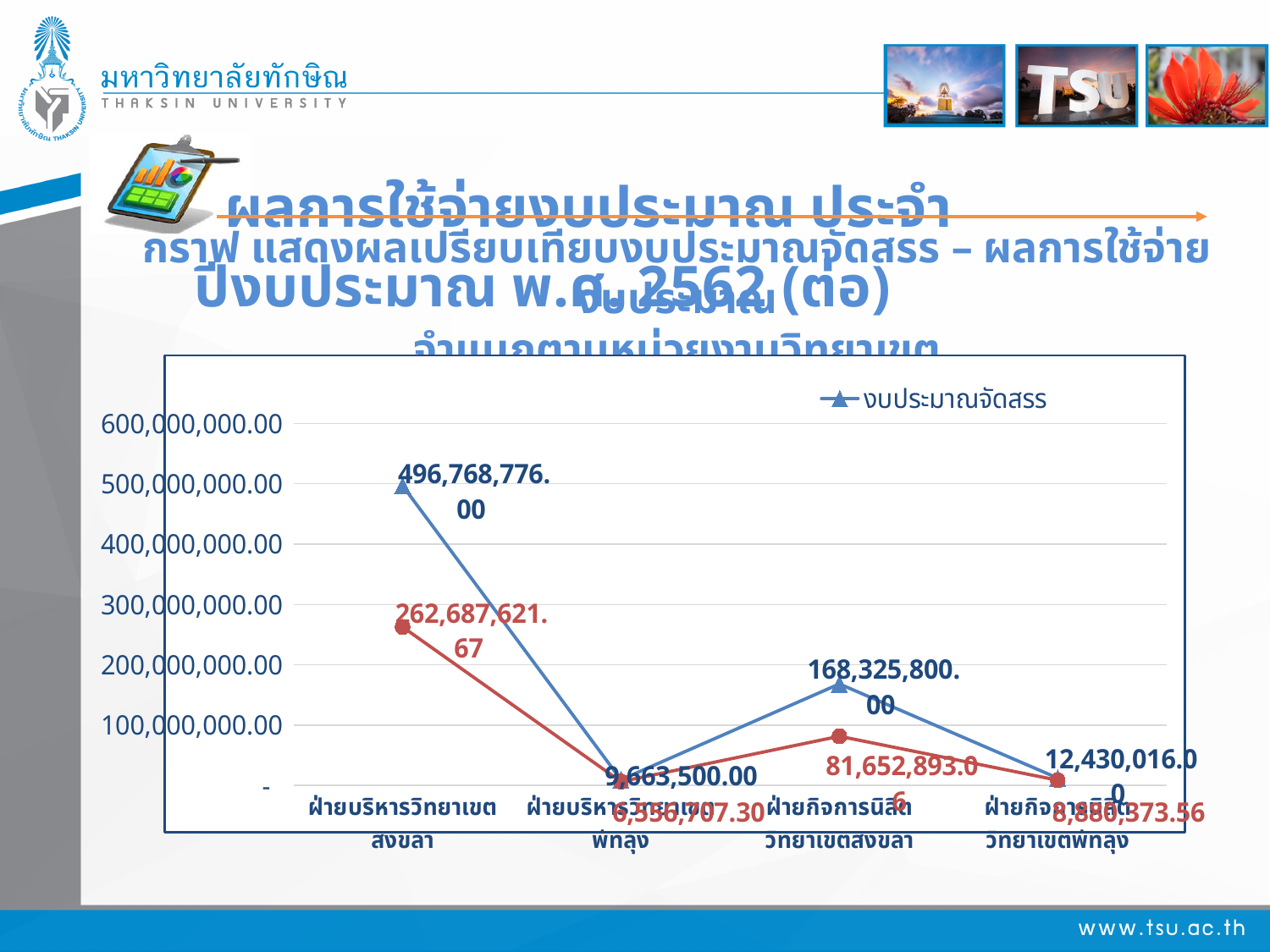
What value does the red line show for ฝ่ายบริหารวิทยาเขตสงขลา? 262,687,621.67 What is the งบประมาณจัดสรร value for ฝ่ายบริหารวิทยาเขตพัทลุง? 9,663,500.00 What is the difference between the งบประมาณจัดสรร value and the red line value for ฝ่ายบริหารวิทยาเขตสงขลา? 234,081,154.33 What series name is shown in the chart legend? งบประมาณจัดสรร Which category has the lowest งบประมาณจัดสรร value? ฝ่ายบริหารวิทยาเขตพัทลุง What is the งบประมาณจัดสรร value for ฝ่ายบริหารวิทยาเขตสงขลา? 496,768,776.00 How many categories are shown on the x axis of the chart? 4 What is the งบประมาณจัดสรร value for ฝ่ายกิจการนิสิตวิทยาเขตสงขลา? 168,325,800.00 Which category has the highest งบประมาณจัดสรร value? ฝ่ายบริหารวิทยาเขตสงขลา For ฝ่ายกิจการนิสิตวิทยาเขตสงขลา, which is larger: the งบประมาณจัดสรร value or the red line value? งบประมาณจัดสรร Is the งบประมาณจัดสรร value for ฝ่ายกิจการนิสิตวิทยาเขตสงขลา greater or less than 200,000,000.00? less What kind of chart is shown on the slide? line chart